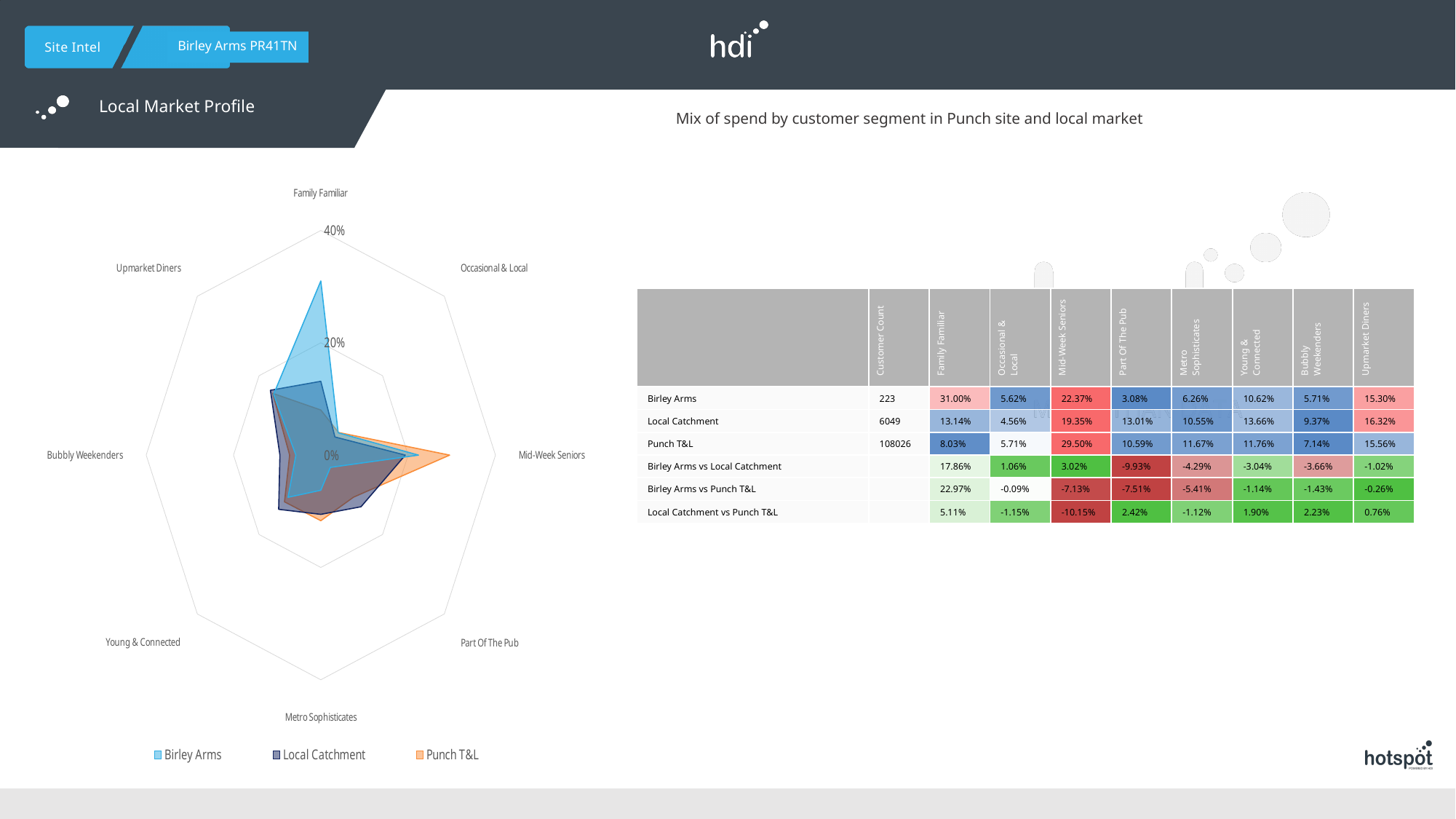
Is the Local Catchment value for Family Familiar greater or less than 20%? less What is the highest percentage tick shown on the radar chart axis? 40% Which series is shown in light blue on the radar chart? Birley Arms For Family Familiar, which is larger: Birley Arms or Local Catchment? Birley Arms What kind of chart is shown on the left of the slide? Radar chart For which category does Punch T&L have its highest value on the radar chart? Mid-Week Seniors Is the Punch T&L value for Mid-Week Seniors greater or less than 20%? greater According to the table, what is the Birley Arms value for Family Familiar? 31.00% For which category does Birley Arms have its highest value on the radar chart? Family Familiar How many customer segment categories are plotted on the radar chart? 8 Is the Birley Arms value for Family Familiar greater or less than 20%? greater How many series does the radar chart legend list? 3